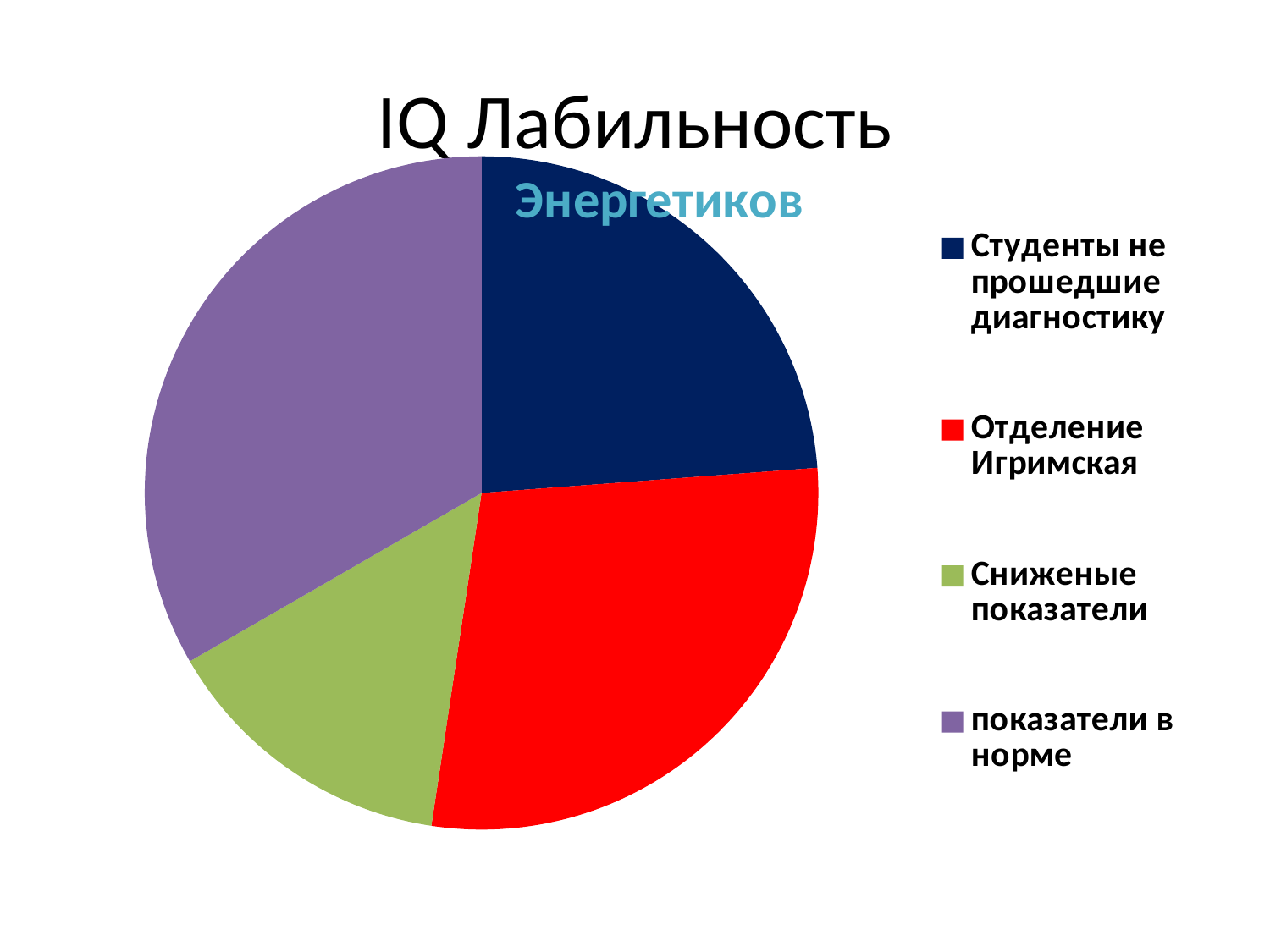
Which slice is larger: "Сниженые показатели" or "Студенты не прошедшие диагностику"? Студенты не прошедшие диагностику What kind of chart is shown on the slide? pie chart Which category has the largest slice of the pie chart? показатели в норме What is the title shown inside the chart area? Энергетиков What colour is the slice for "Отделение Игримская"? red Which category has the smallest slice of the pie chart? Сниженые показатели How many entries does the legend of the pie chart list? 4 Which slice is larger: "показатели в норме" or "Сниженые показатели"? показатели в норме How many slices does the pie chart have? 4 Which slice is larger: "показатели в норме" or "Отделение Игримская"? показатели в норме